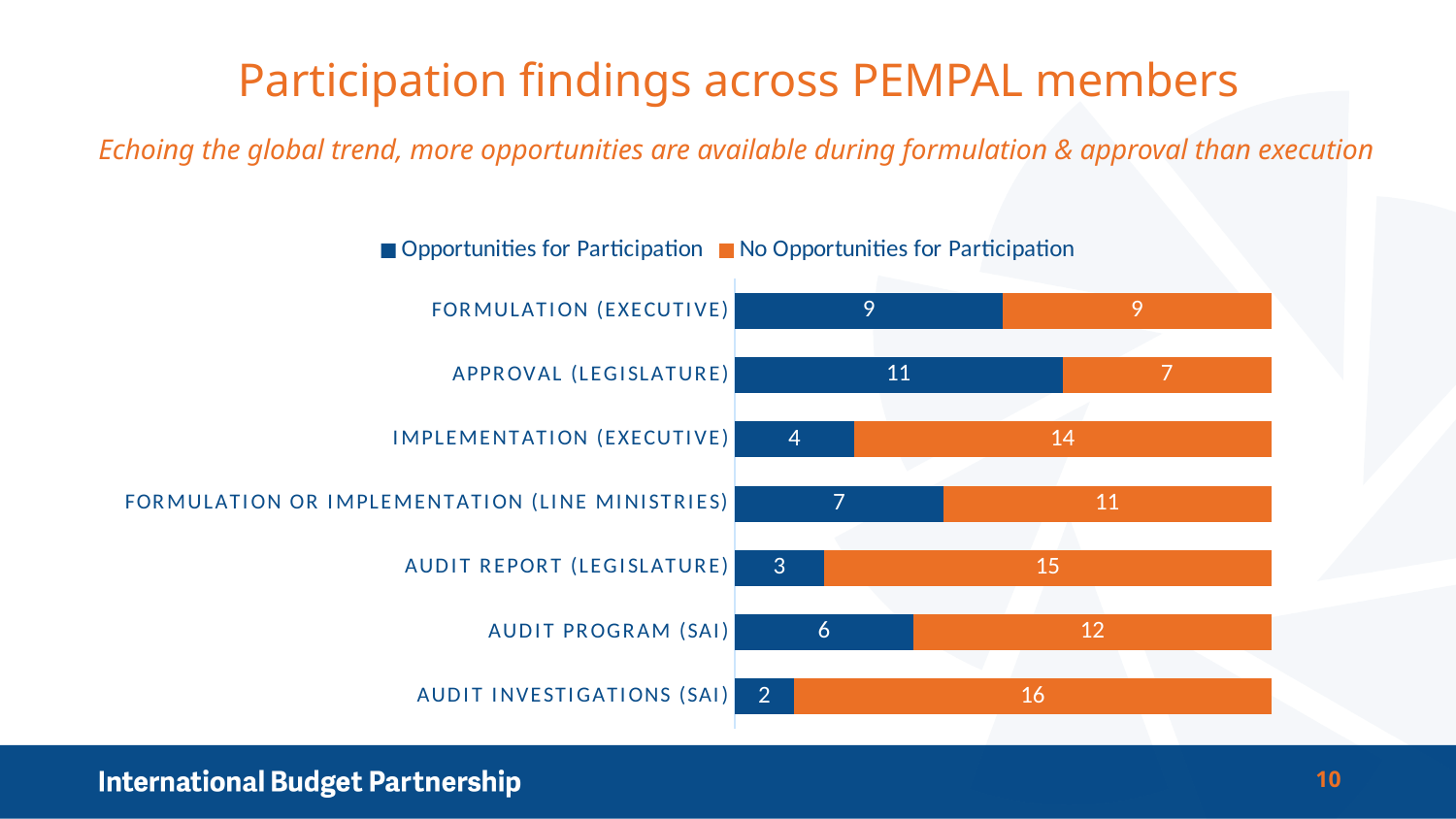
What is the difference between the No Opportunities for Participation and Opportunities for Participation values for Audit Report (Legislature)? 12 Which category has the lowest value for Opportunities for Participation? Audit Investigations (SAI) What is the value for Opportunities for Participation in the Implementation (Executive) category? 4 Which colour represents No Opportunities for Participation in the chart? Orange What kind of chart is shown on the slide? Stacked bar chart What is the value for Opportunities for Participation in the Approval (Legislature) category? 11 What is the value for No Opportunities for Participation in the Audit Investigations (SAI) category? 16 How many categories are shown on the chart? 7 Which category has the highest value for Opportunities for Participation? Approval (Legislature) What is the total of the stacked bar for Audit Program (SAI)? 18 Which is larger for Formulation or Implementation (Line Ministries): Opportunities for Participation or No Opportunities for Participation? No Opportunities for Participation How many series does the legend list? 2